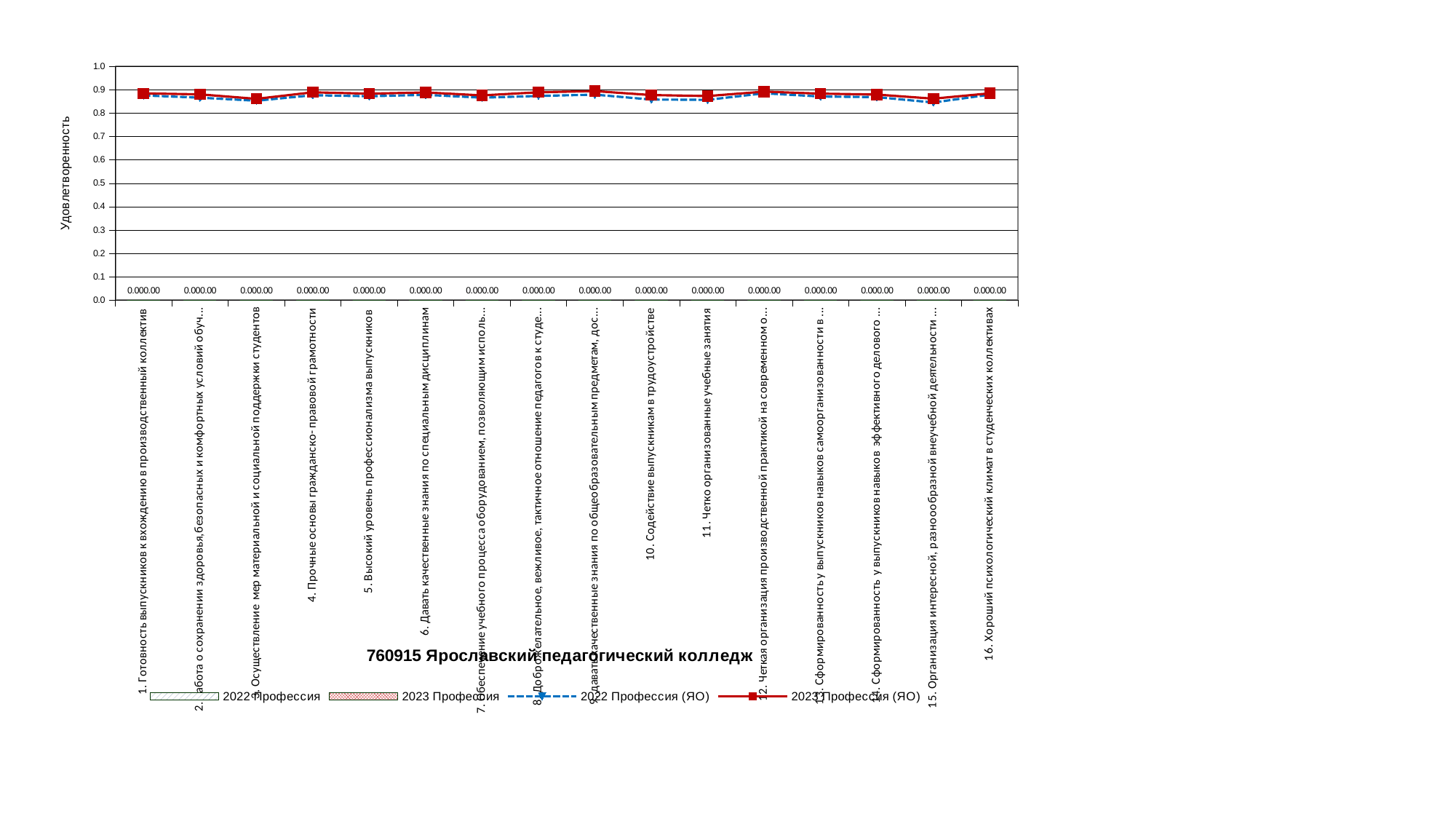
What kind of chart is used to plot the series 2023 Профессия (ЯО)? line chart For category 10 (Содействие выпускникам в трудоустройстве), which series has the higher value: 2022 Профессия (ЯО) or 2023 Профессия (ЯО)? 2023 Профессия (ЯО) What is the label on the vertical axis of the chart? Удовлетворенность How many series does the chart legend list? 4 How many categories are shown along the x axis of the chart? 16 Is the value of 2023 Профессия (ЯО) for category 1 (Готовность выпускников к вхождению в производственный коллектив) greater or less than 0.5? greater Do the values of the 2023 Профессия (ЯО) line rise, fall, or stay roughly flat across the categories? stay roughly flat Is the value of 2023 Профессия (ЯО) for category 8 greater or less than 0.7? greater Is the value of 2022 Профессия (ЯО) for category 3 (Осуществление мер материальной и социальной поддержки студентов) greater or less than 0.9? less What is the title of the chart? 760915 Ярославский педагогический колледж